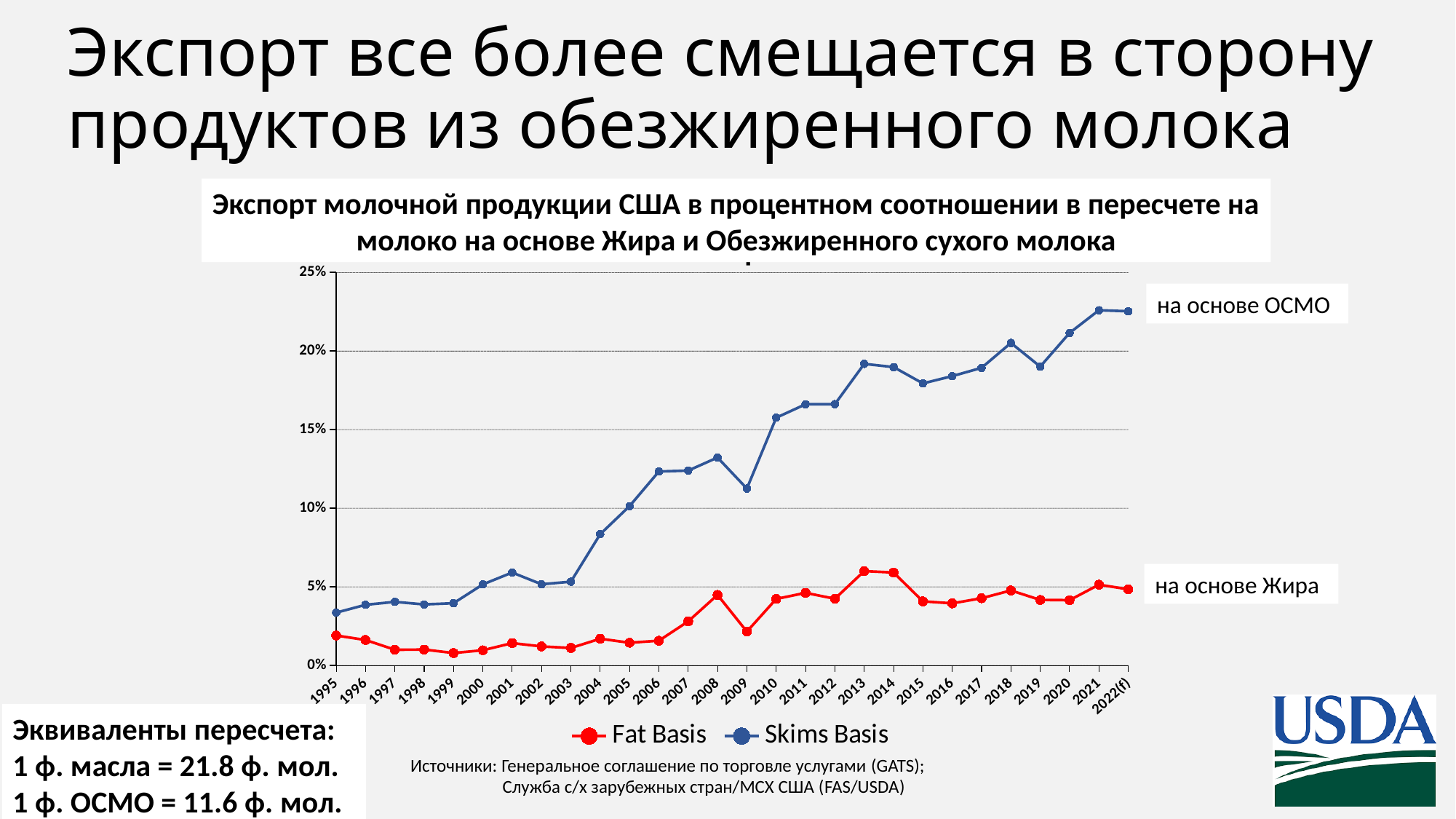
What colour is the Fat Basis line? red For the Skims Basis series, which year has the larger value, 2008 or 2009? 2008 Which series has the larger value in 2022(f), Fat Basis or Skims Basis? Skims Basis Does the Skims Basis series generally rise or fall from 1995 to 2022(f)? rise How many years (points) are plotted along the x axis? 28 How many series does the chart legend list? 2 What are the two series named in the chart legend? Fat Basis and Skims Basis Is the Skims Basis value for 2009 greater or less than 10%? greater Is the Fat Basis value for 2009 greater or less than 5%? less Is the Skims Basis value for 2010 greater or less than 15%? greater What kind of chart is shown on the slide? line chart